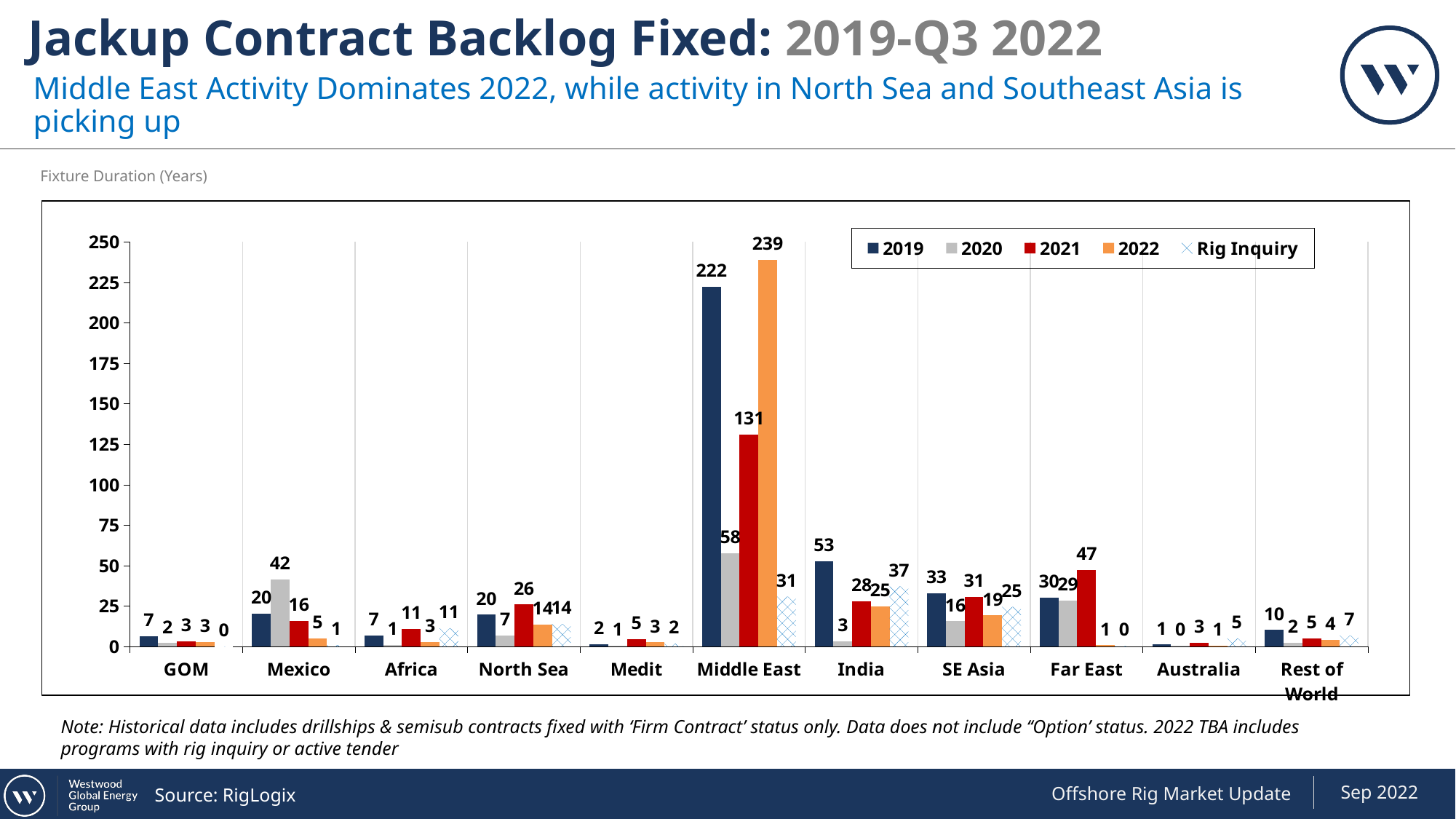
What kind of chart is shown on the slide? Bar chart Which is larger for North Sea, the 2021 value or the 2019 value? 2021 How many series does the legend list? 5 Which region has the highest 2019 value? Middle East What is the difference between the 2022 and 2019 values for Middle East? 17 What is the Rig Inquiry value for India? 37 What is the 2021 value for Far East? 47 How many regions are shown on the x axis? 11 What is the label on the y axis above the chart? Fixture Duration (Years) Is the 2021 value for Middle East greater or less than 125? greater What is the 2020 value for Mexico? 42 What is the 2022 value for Middle East? 239